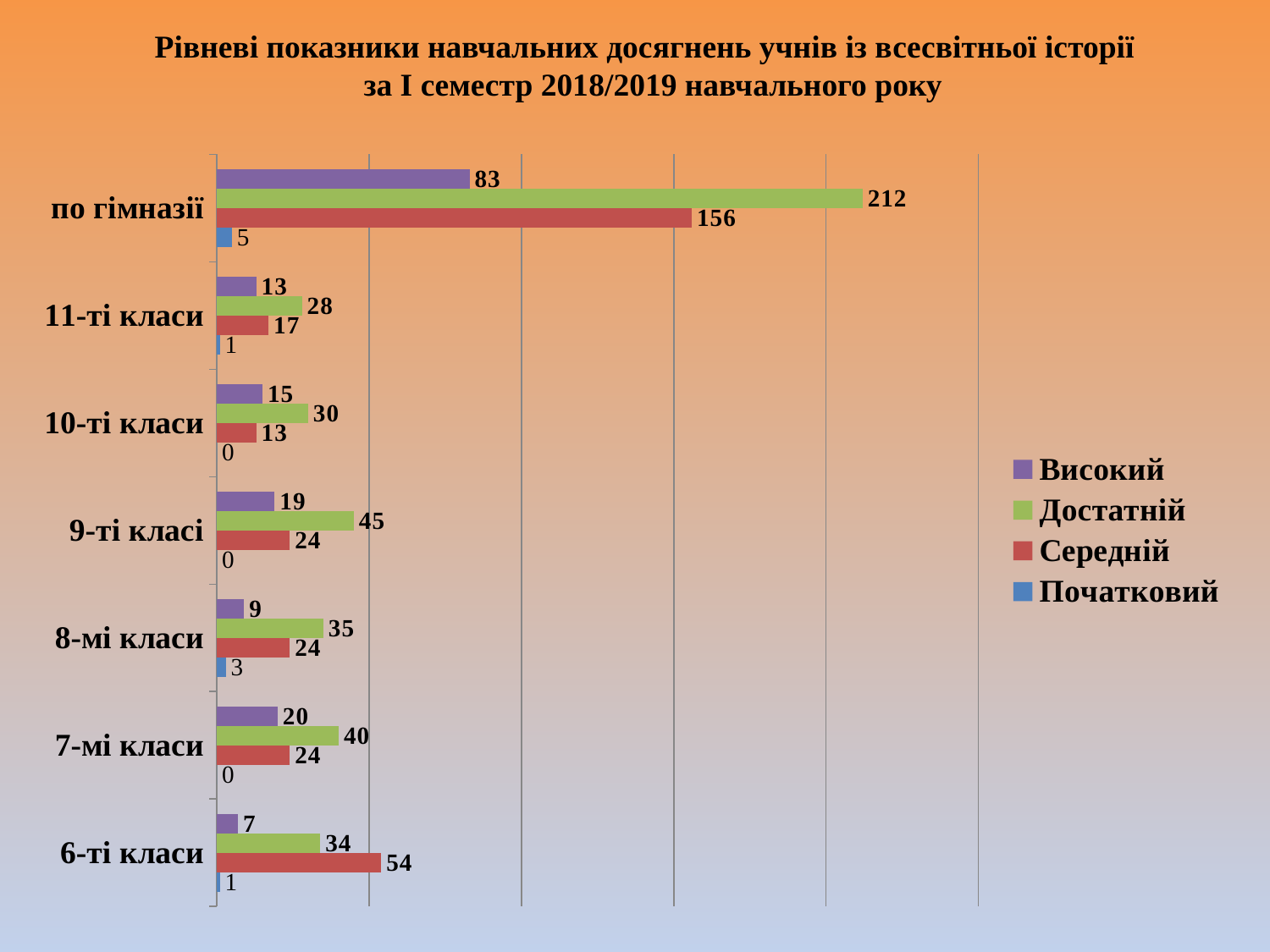
How many categories are shown on the vertical axis? 7 What is the value of Початковий for 8-мі класи? 3 What is the value of Достатній for по гімназії? 212 How many series does the legend list? 4 What is the difference between Достатній and Середній for по гімназії? 56 Which series is shown in green in the legend? Достатній Which class category has the lowest Високий value? 6-ті класи Which class category has the highest Достатній value (excluding по гімназії)? 9-ті класі What is the value of Середній for 6-ті класи? 54 Which is larger for 10-ті класи: Високий or Середній? Високий What type of chart is shown on the slide? bar chart What is the value of Високий for 9-ті класі? 19